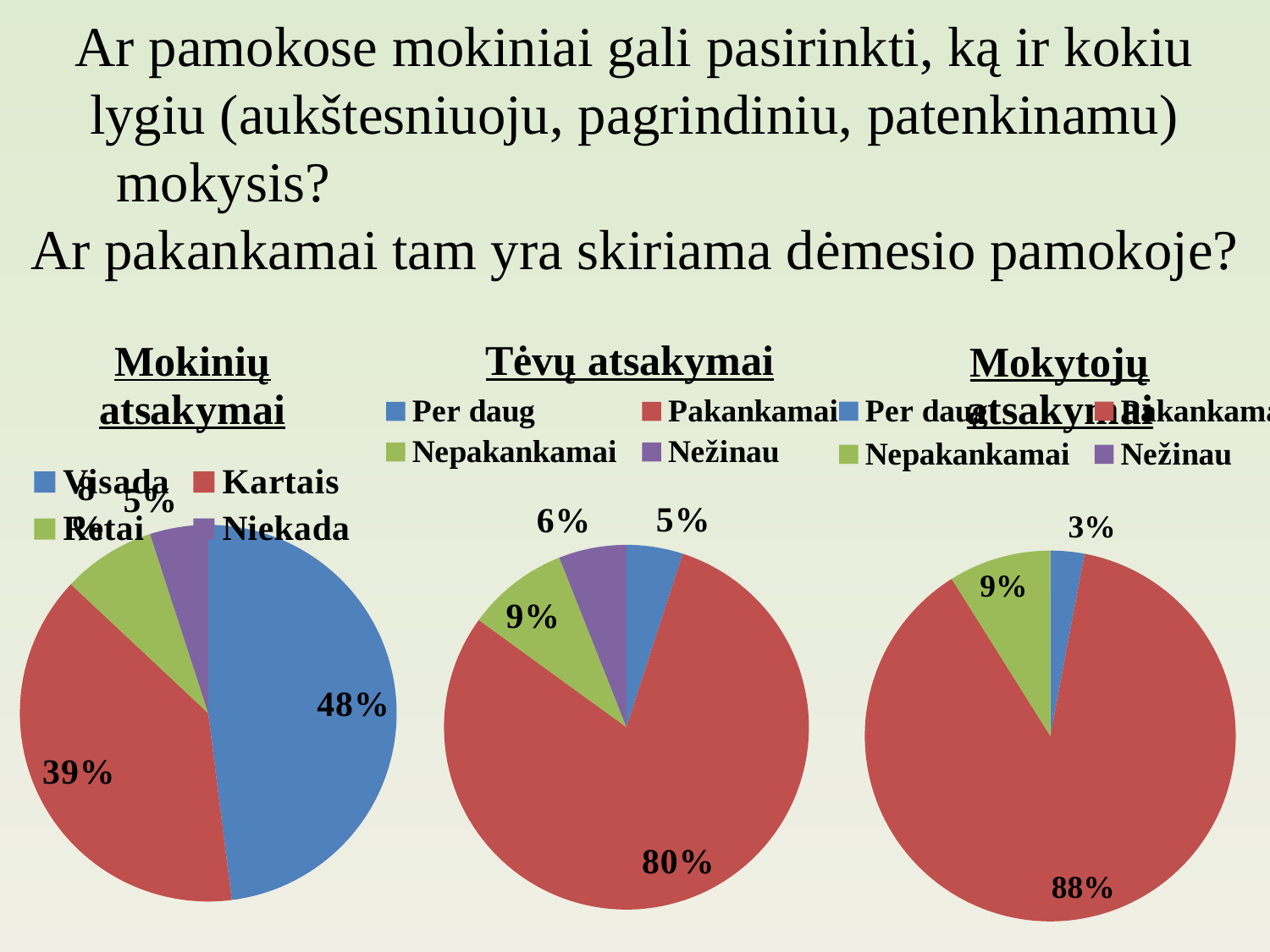
In the 'Mokinių atsakymai' chart, what percentage is shown for Visada? 48% In the 'Tėvų atsakymai' chart, what percentage is shown for Nežinau? 6% In the 'Mokytojų atsakymai' chart, what percentage is shown for Per daug? 3% In the 'Tėvų atsakymai' chart, which category has the smallest slice? Per daug In the 'Tėvų atsakymai' chart, what percentage is shown for Pakankamai? 80% In the 'Tėvų atsakymai' chart, which is larger: Nepakankamai or Nežinau? Nepakankamai How many entries does the legend of the 'Mokytojų atsakymai' chart list? 4 In the 'Mokinių atsakymai' chart, which category has the largest slice? Visada In the 'Mokinių atsakymai' chart, what percentage is shown for Kartais? 39% What type of chart is used for 'Tėvų atsakymai'? Pie chart In the 'Mokytojų atsakymai' chart, what percentage is shown for Pakankamai? 88% In the 'Mokinių atsakymai' chart, what is the difference between the Visada and Kartais slices? 9%